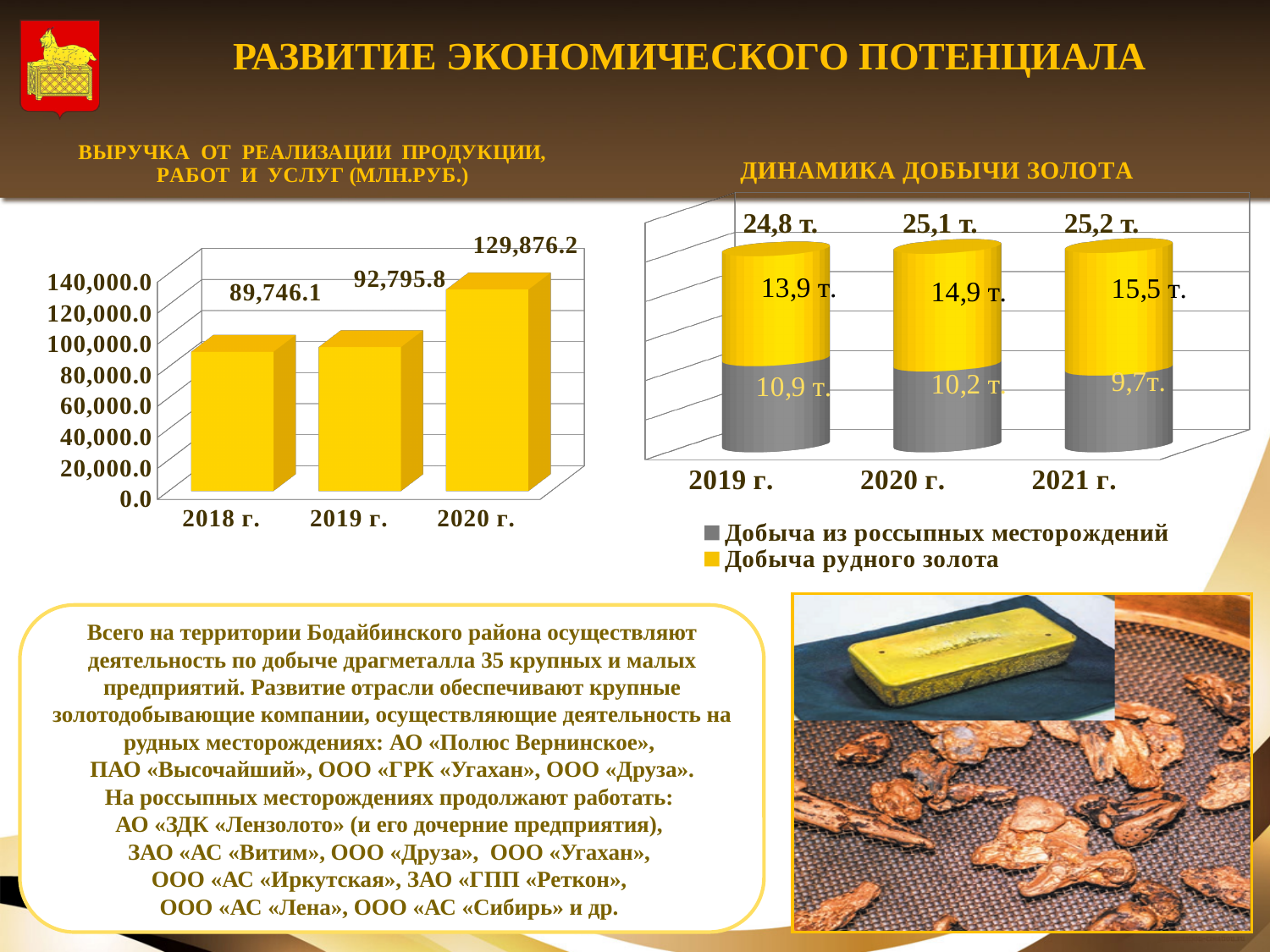
On the chart titled 'ВЫРУЧКА ОТ РЕАЛИЗАЦИИ ПРОДУКЦИИ, РАБОТ И УСЛУГ (МЛН.РУБ.)', how many years are shown? 3 On the chart titled 'ДИНАМИКА ДОБЫЧИ ЗОЛОТА', which is larger for 2021 г.: 'Добыча рудного золота' or 'Добыча из россыпных месторождений'? Добыча рудного золота On the chart titled 'ВЫРУЧКА ОТ РЕАЛИЗАЦИИ ПРОДУКЦИИ, РАБОТ И УСЛУГ (МЛН.РУБ.)', what is the difference between the values for 2020 г. and 2019 г.? 37,080.4 On the chart titled 'ДИНАМИКА ДОБЫЧИ ЗОЛОТА', what is the value of 'Добыча из россыпных месторождений' for 2019 г.? 10,9 т. On the chart titled 'ДИНАМИКА ДОБЫЧИ ЗОЛОТА', what is the total for 2021 г.? 25,2 т. On the chart titled 'ДИНАМИКА ДОБЫЧИ ЗОЛОТА', how many series does the legend list? 2 On the chart titled 'ВЫРУЧКА ОТ РЕАЛИЗАЦИИ ПРОДУКЦИИ, РАБОТ И УСЛУГ (МЛН.РУБ.)', what is the value for 2018 г.? 89,746.1 On the chart titled 'ВЫРУЧКА ОТ РЕАЛИЗАЦИИ ПРОДУКЦИИ, РАБОТ И УСЛУГ (МЛН.РУБ.)', do the values rise or fall from 2018 г. to 2020 г.? rise On the chart titled 'ВЫРУЧКА ОТ РЕАЛИЗАЦИИ ПРОДУКЦИИ, РАБОТ И УСЛУГ (МЛН.РУБ.)', which year has the lowest value? 2018 г. On the chart titled 'ДИНАМИКА ДОБЫЧИ ЗОЛОТА', what is the value of 'Добыча рудного золота' for 2020 г.? 14,9 т. On the chart titled 'ВЫРУЧКА ОТ РЕАЛИЗАЦИИ ПРОДУКЦИИ, РАБОТ И УСЛУГ (МЛН.РУБ.)', what is the value for 2020 г.? 129,876.2 What kind of chart is the one titled 'ВЫРУЧКА ОТ РЕАЛИЗАЦИИ ПРОДУКЦИИ, РАБОТ И УСЛУГ (МЛН.РУБ.)'? bar chart